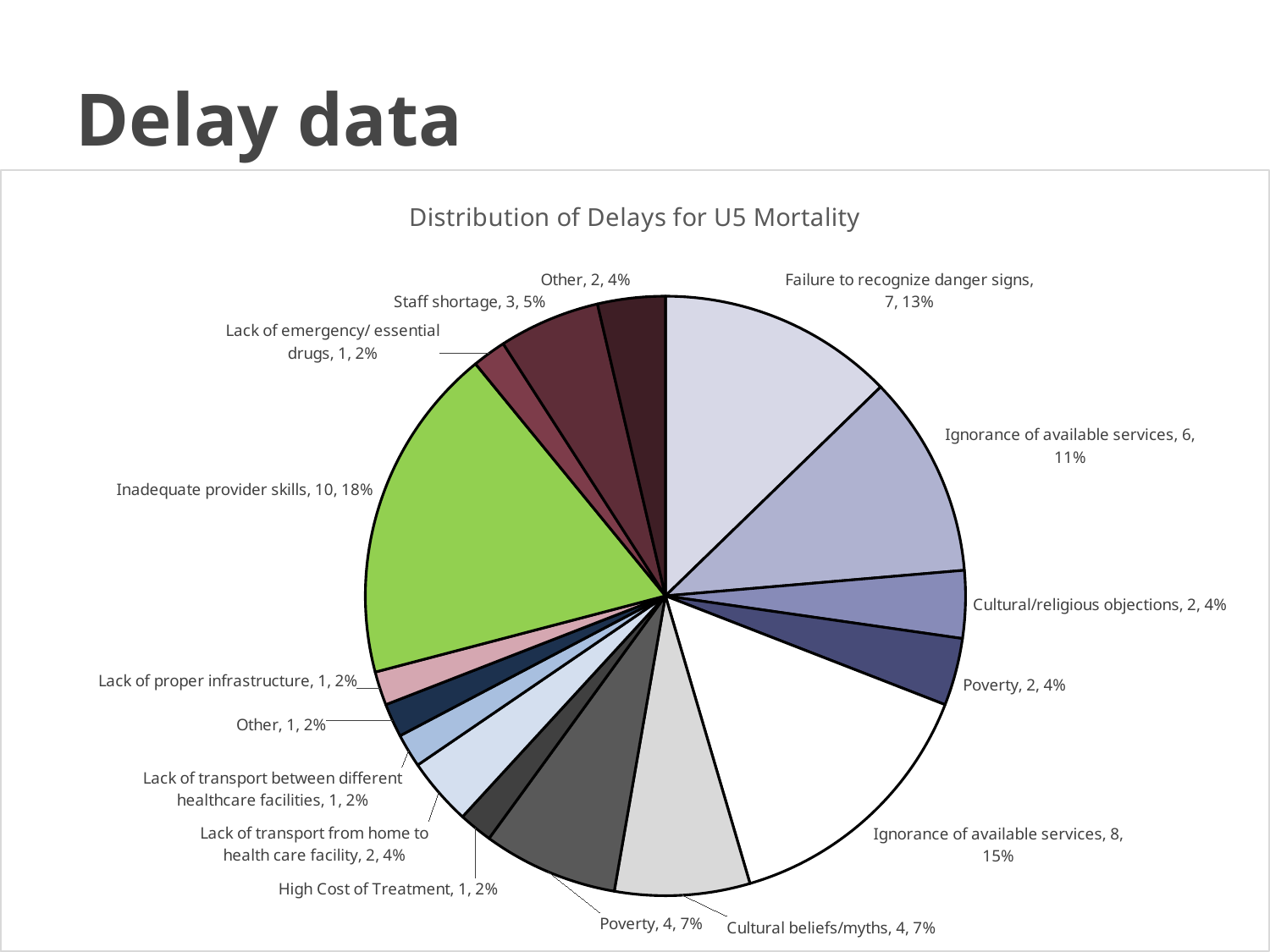
What share of the pie does Cultural beliefs/myths represent? 7% What share of the pie does High Cost of Treatment represent? 2% What is the value shown for Failure to recognize danger signs? 7 Which is larger, the value for Failure to recognize danger signs or the value for Cultural beliefs/myths? Failure to recognize danger signs What is the value shown for Staff shortage? 3 What share of the pie does Inadequate provider skills represent? 18% How many slices does the pie chart have? 16 What is the difference between the values for Inadequate provider skills and Staff shortage? 7 What is the value shown for Lack of transport from home to health care facility? 2 Which category has the largest slice of the pie? Inadequate provider skills What kind of chart is shown on the slide? pie chart What is the title of the chart? Distribution of Delays for U5 Mortality